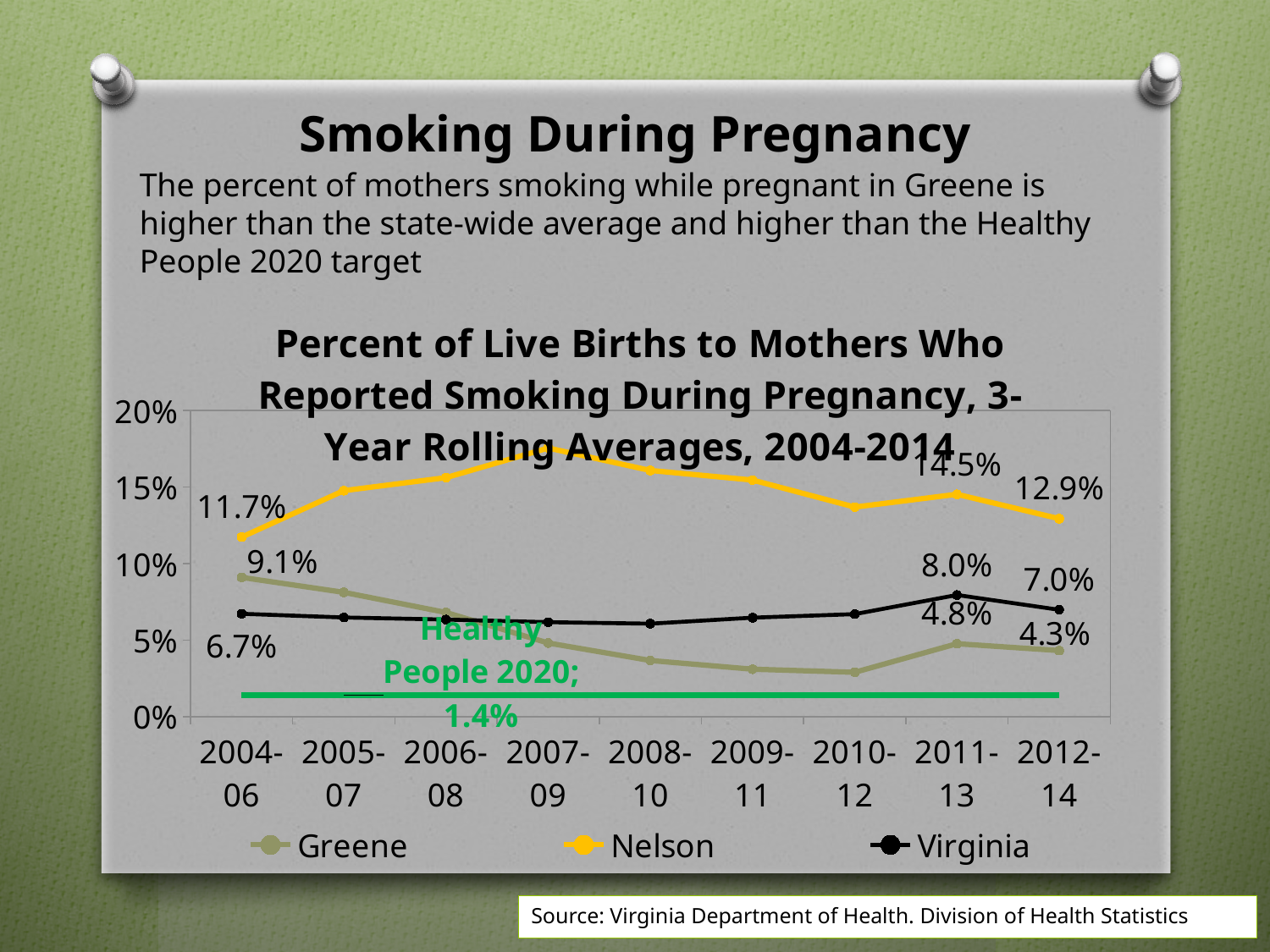
What is the value for Greene in 2004-06? 9.1% Is the value for Nelson in 2007-09 greater or less than 15%? greater Does the Greene line rise or fall from 2004-06 to 2010-12? Fall What kind of chart is shown on the slide? Line chart What is the value for Virginia in 2004-06? 6.7% By how many percentage points did the Greene value fall from 2004-06 to 2012-14? 4.8% What is the value for Nelson in 2012-14? 12.9% What is the value for Virginia in 2011-13? 8.0% How many series does the chart legend list? 3 What is the Healthy People 2020 target value shown on the chart? 1.4% How many time periods are shown on the x axis of the chart? 9 Which is larger in 2012-14, the value for Nelson or the value for Virginia? Nelson